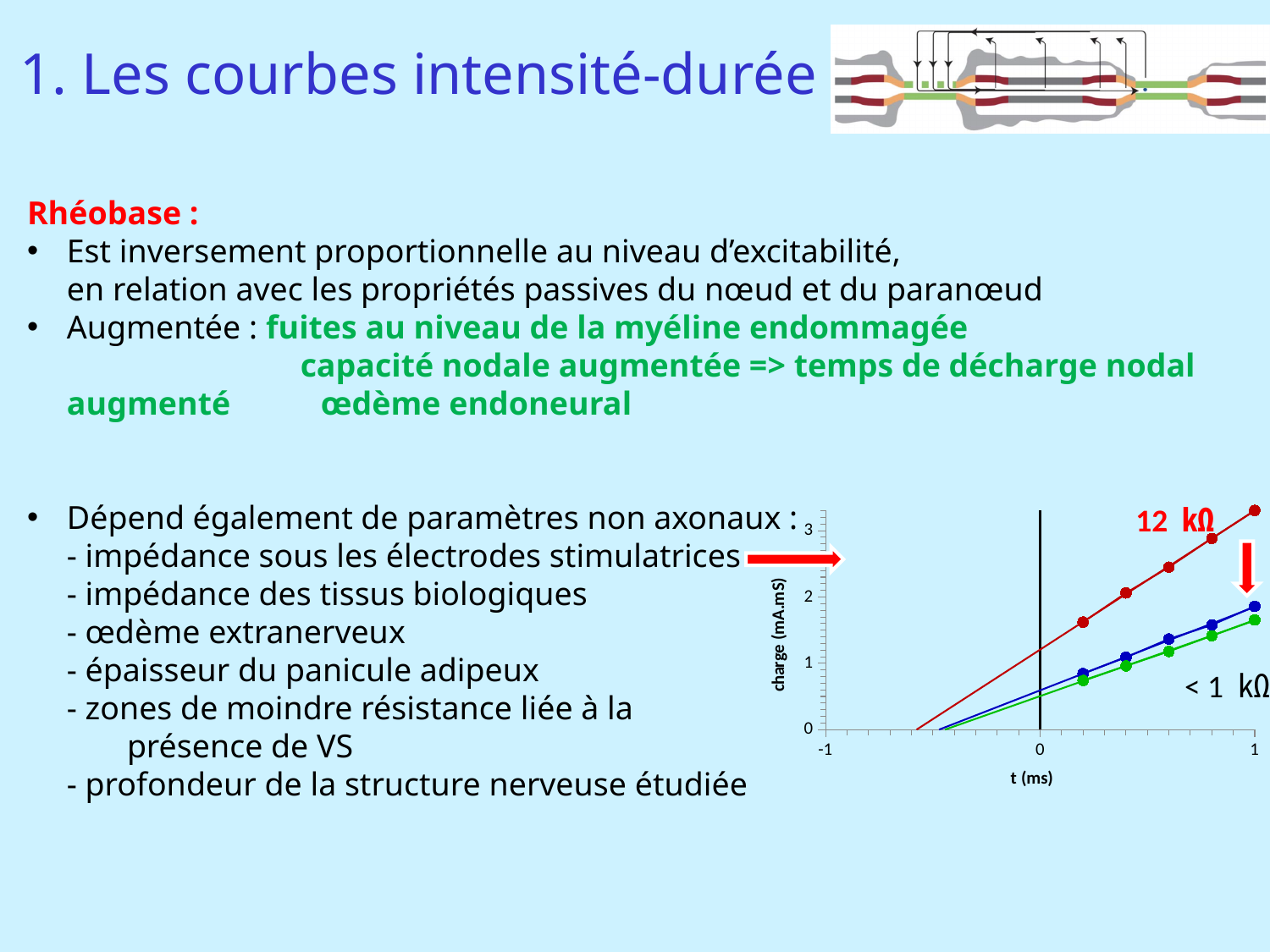
How many data series (lines) are plotted on the chart? 3 Is the charge of the green line at t = 1 ms greater or less than 2? less Is the charge of the red line at t = 0.6 ms greater or less than 2? greater Do the values of the red line rise or fall as t increases? rise What is the label of the y axis of the chart? charge (mA.mS) Which line has the lowest charge at t = 1 ms? the green line What is the label of the x axis of the chart? t (ms) What kind of chart is shown on the slide? line chart (scatter with lines) Which line has the highest charge at t = 1 ms? the red line How many data points are plotted on the red line? 5 At t = 1 ms, is the charge of the red line or the green line larger? the red line Is the charge of the blue line at t = 0.2 ms greater or less than 1? less